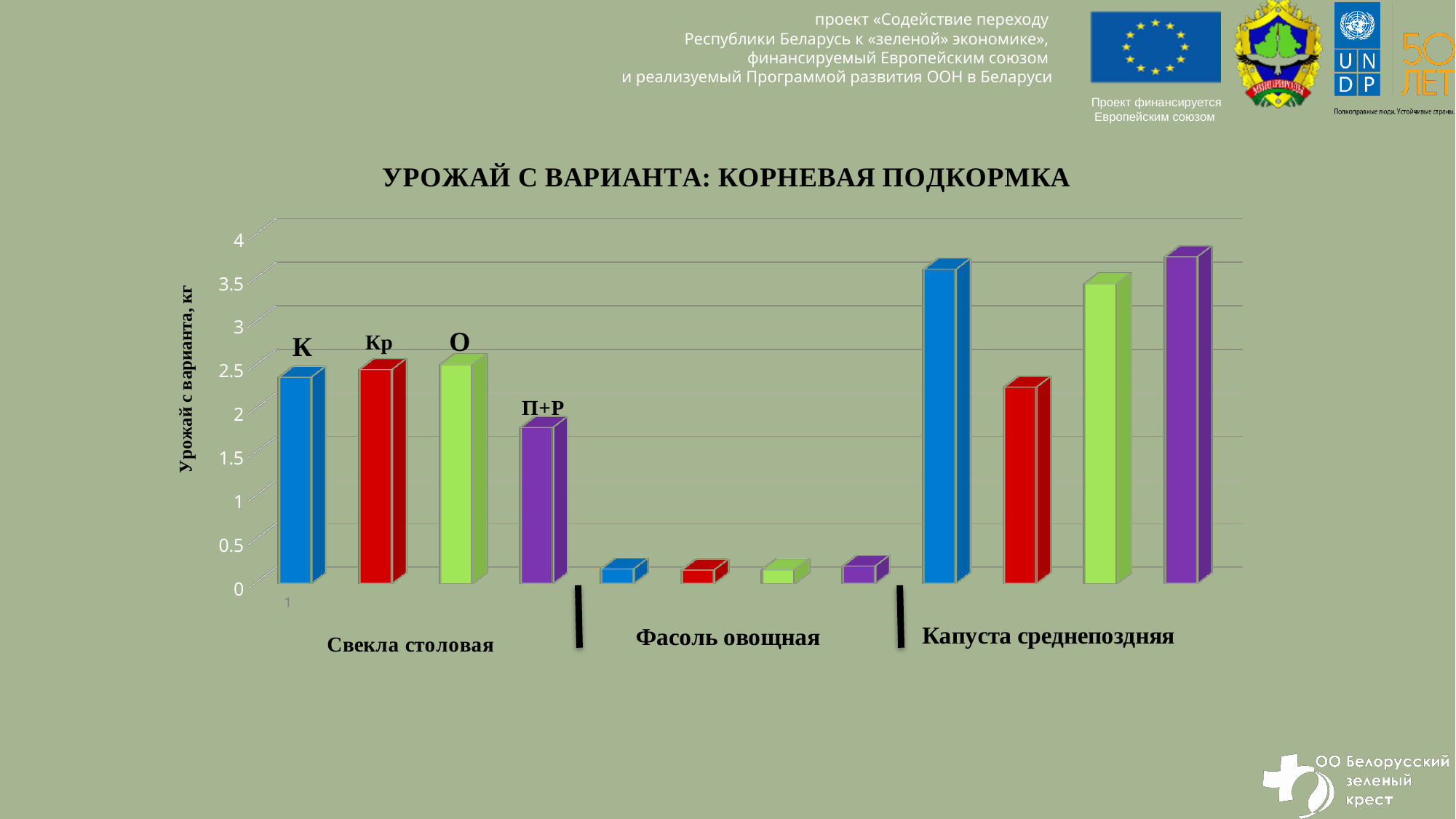
Which crop has the lowest yields across all variants? Фасоль овощная How many crop categories are shown along the x axis? 3 What is the label of the vertical axis? Урожай с варианта, кг For Свекла столовая, which variant has the lowest yield? П+Р Is the yield for the Кр variant of Капуста среднепоздняя greater or less than 2.5? less For Капуста среднепоздняя, which variant has the lowest yield? Кр What is the title of the chart? УРОЖАЙ С ВАРИАНТА: КОРНЕВАЯ ПОДКОРМКА Is the yield for the П+Р variant of Свекла столовая greater or less than 2? less How many treatment variants (bars) are shown for each crop? 4 Which is larger: the К variant yield for Свекла столовая or for Капуста среднепоздняя? Капуста среднепоздняя For Капуста среднепоздняя, which variant has the highest yield? П+Р What kind of chart is shown on the slide? bar chart